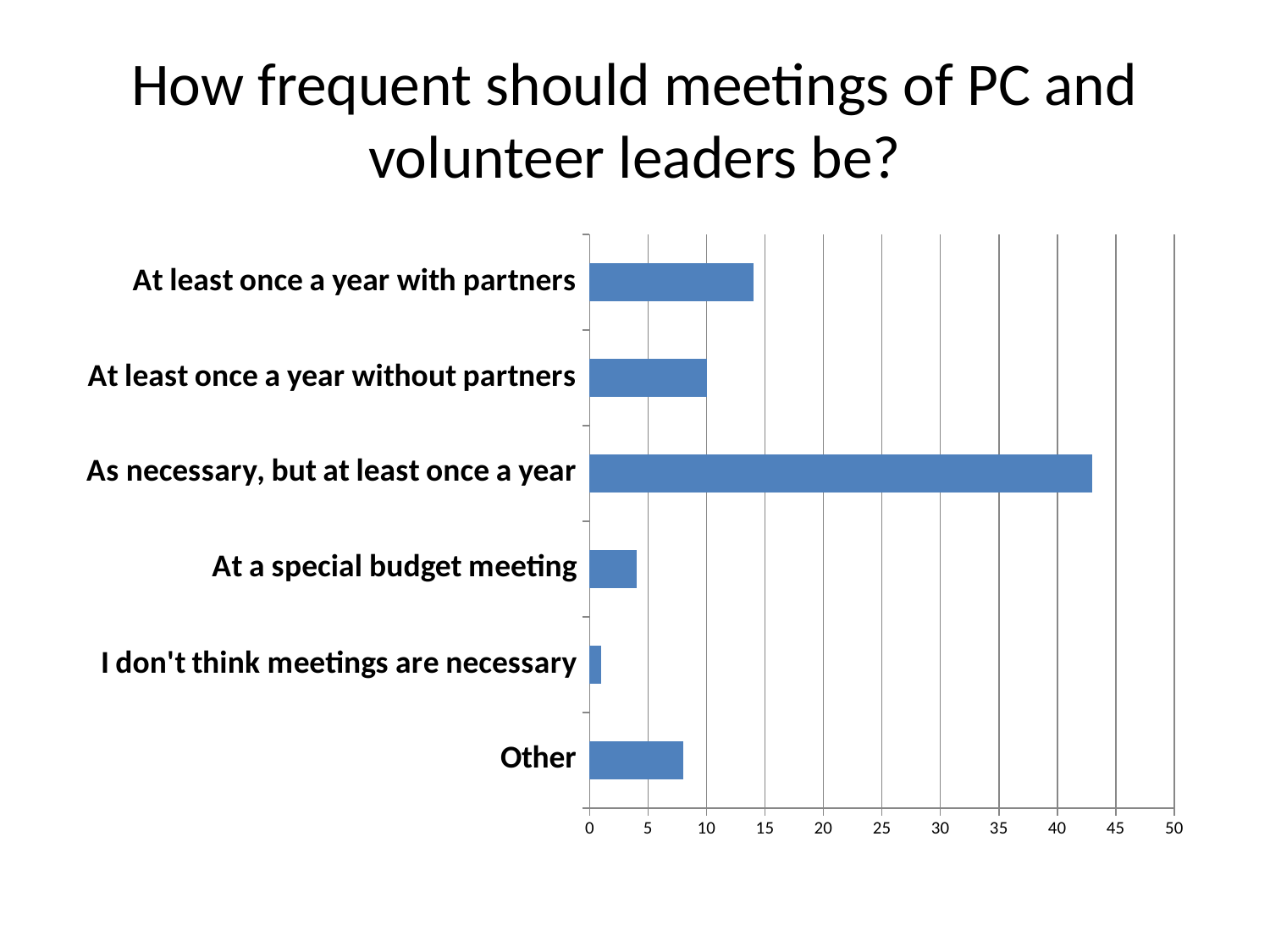
Which category has the highest value? As necessary, but at least once a year How many categories are shown in the chart? 6 Which is larger, the value for "At a special budget meeting" or the value for "At least once a year without partners"? At least once a year without partners What kind of chart is shown on the slide? bar chart Is the value for "As necessary, but at least once a year" greater or less than 45? less Is the value for "At a special budget meeting" greater or less than 5? less Which category has the lowest value? I don't think meetings are necessary Is the value for "Other" greater or less than 5? greater What is the title of the slide containing the chart? How frequent should meetings of PC and volunteer leaders be? Which is larger, the value for "At least once a year with partners" or the value for "Other"? At least once a year with partners